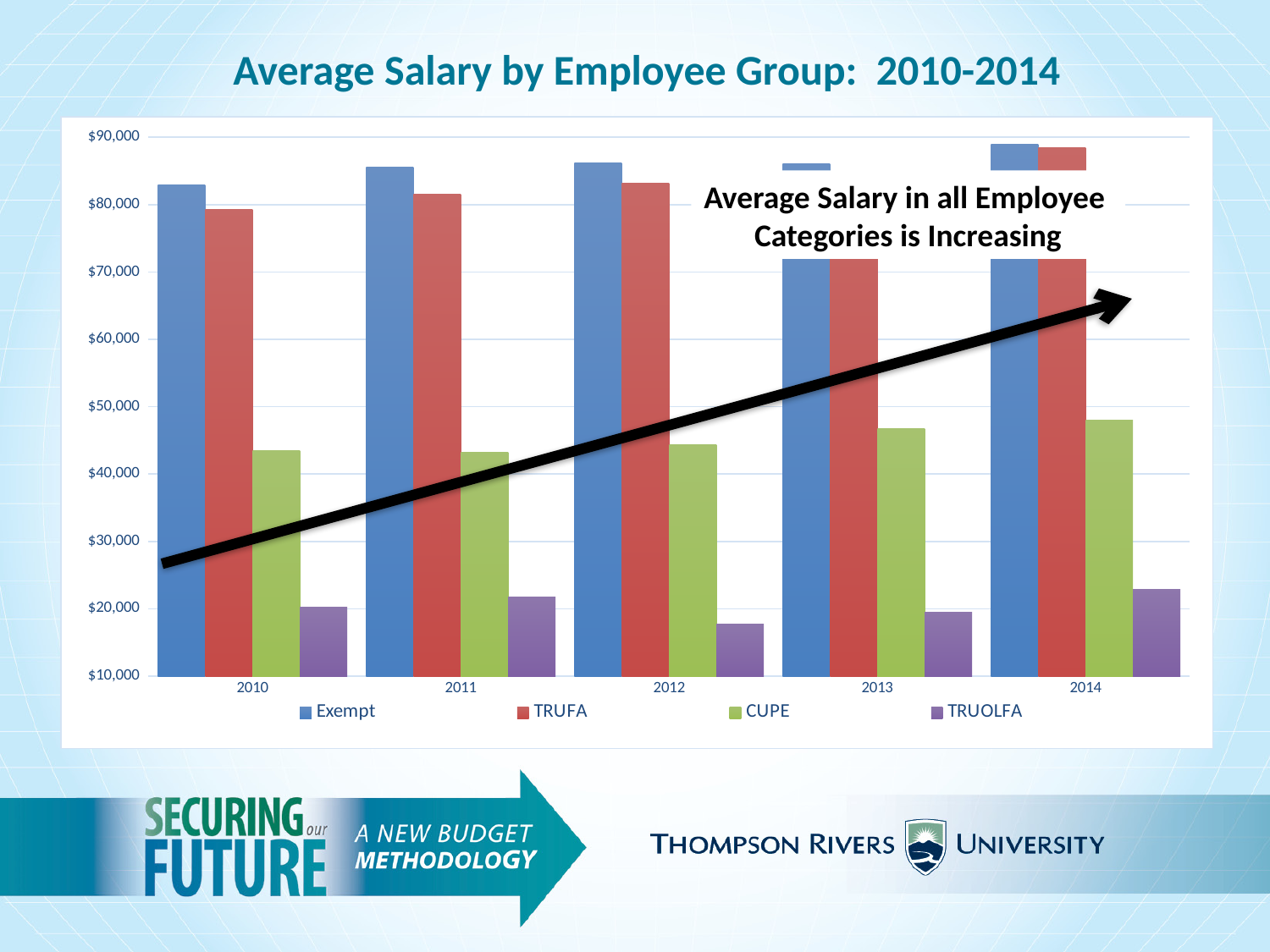
What is the title of the chart? Average Salary by Employee Group: 2010-2014 Is the value for TRUOLFA in 2012 greater or less than $20,000? less How many series does the legend list? 4 Is the value for Exempt in 2010 greater or less than $80,000? greater Which employee group has the lowest average salary in every year shown? TRUOLFA Which employee group has the highest average salary in 2010? Exempt Is the value for CUPE in 2014 greater or less than $50,000? less What kind of chart is shown on the slide? bar chart How many years are shown along the x axis? 5 Do the CUPE values generally rise or fall from 2010 to 2014? rise Which is larger in 2012, the value for CUPE or the value for TRUOLFA? CUPE